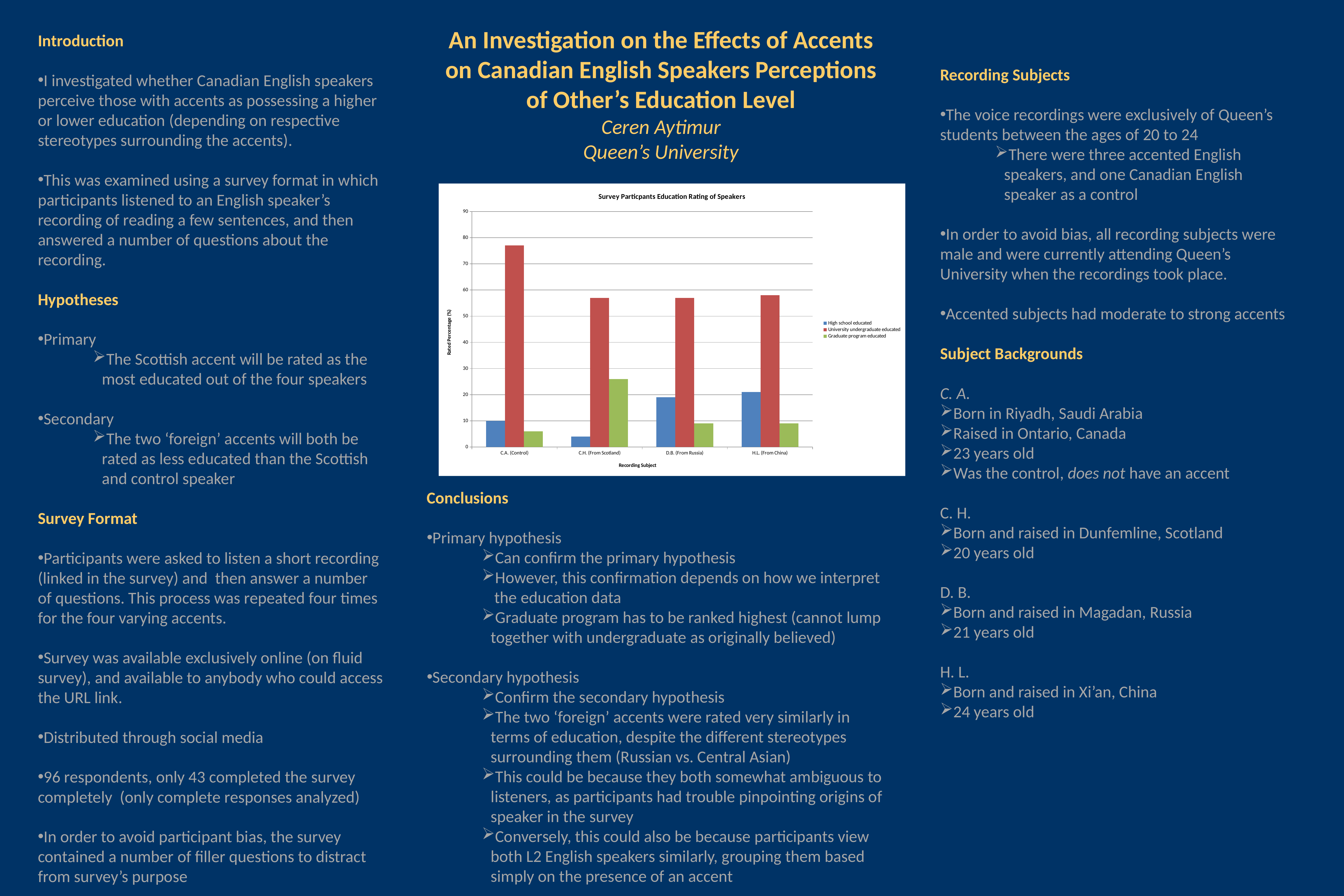
Which recording subject has the highest 'University undergraduate educated' rating? C.A. (Control) Which recording subject has the highest 'Graduate program educated' rating? C.H. (From Scotland) Is the 'Graduate program educated' value for C.H. (From Scotland) greater or less than 20? greater What is the title of the chart? Survey Particpants Education Rating of Speakers How many recording subjects (categories) are shown on the x axis of the chart? 4 Is the 'High school educated' value for C.H. (From Scotland) greater or less than 10? less How many series does the chart's legend list? 3 Which is larger: the 'Graduate program educated' value for C.H. (From Scotland) or for D.B. (From Russia)? C.H. (From Scotland) Is the 'University undergraduate educated' value for C.A. (Control) greater or less than 70? greater Which recording subject has the lowest 'High school educated' rating? C.H. (From Scotland) What is the label of the chart's x axis? Recording Subject What type of chart is shown on the slide? bar chart